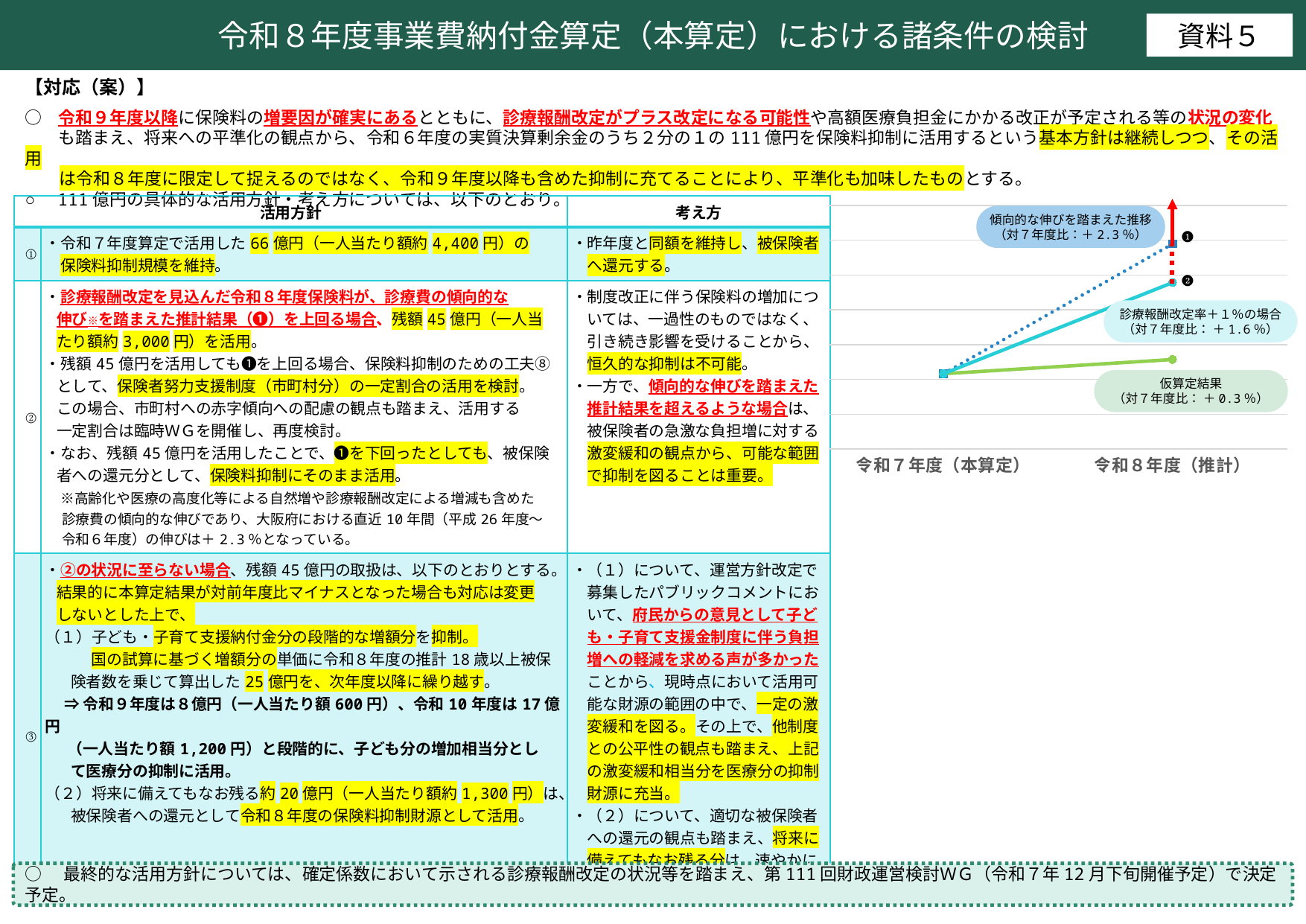
Which line is lowest at 令和８年度（推計） in the chart? 仮算定結果 In the chart, what is the difference between the 対７年度比 of 傾向的な伸びを踏まえた推移 (＋2.3％) and 診療報酬改定率＋１％の場合 (＋1.6％)? 0.7％ Do the lines in the chart rise or fall from 令和７年度（本算定） to 令和８年度（推計）? rise In the chart, what 対７年度比 value is shown for 傾向的な伸びを踏まえた推移? ＋2.3％ How many lines are plotted in the chart? 3 In the chart, what 対７年度比 value is shown for 仮算定結果? ＋0.3％ What kind of chart is shown on the right side of the slide? line chart In the chart, which is larger at 令和８年度（推計）: 診療報酬改定率＋１％の場合 or 仮算定結果? 診療報酬改定率＋１％の場合 Which line reaches the highest point at 令和８年度（推計） in the chart? 傾向的な伸びを踏まえた推移 What are the two x-axis labels of the chart? 令和７年度（本算定）, 令和８年度（推計） How many categories are shown on the x axis of the chart? 2 In the chart, what 対７年度比 value is shown for 診療報酬改定率＋１％の場合? ＋1.6％